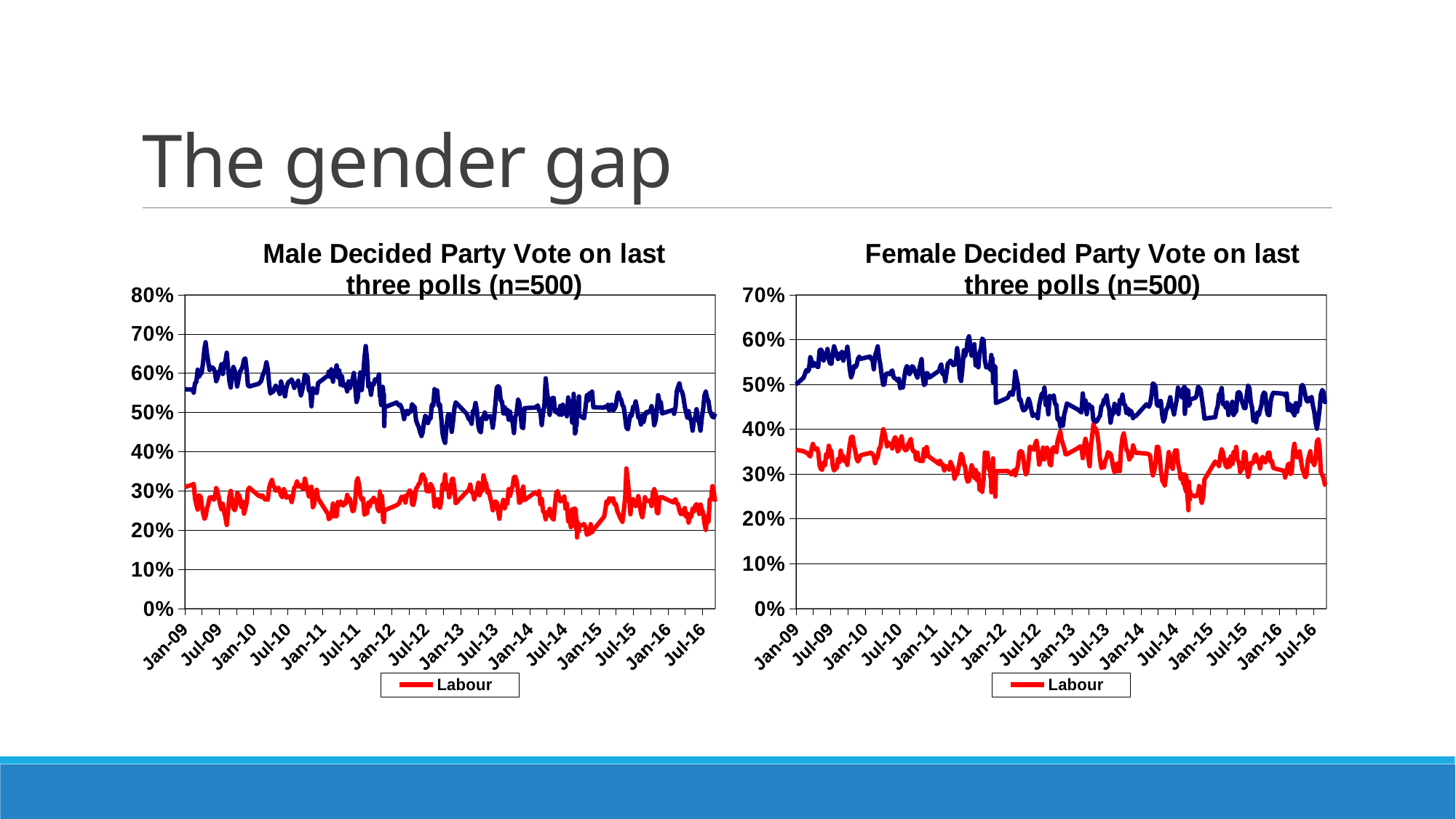
In the Female Decided Party Vote chart, does the blue line overall rise or fall from Jan-09 to Jul-16? fall In the Male Decided Party Vote chart, is the Labour value at Jan-15 greater or less than 30%? less In the Male Decided Party Vote chart, is the blue line's value at Jul-09 greater or less than 50%? greater In the Female Decided Party Vote chart, is the Labour value at Jan-09 greater or less than 30%? greater What is the highest value shown on the y axis of the Male Decided Party Vote chart? 80% What series name appears in the legend of the Male Decided Party Vote chart? Labour What kind of chart is the Male Decided Party Vote chart? line chart In the Male Decided Party Vote chart, which line is higher across the whole period, the blue line or the red Labour line? the blue line How many series does the legend of the Female Decided Party Vote chart list? 1